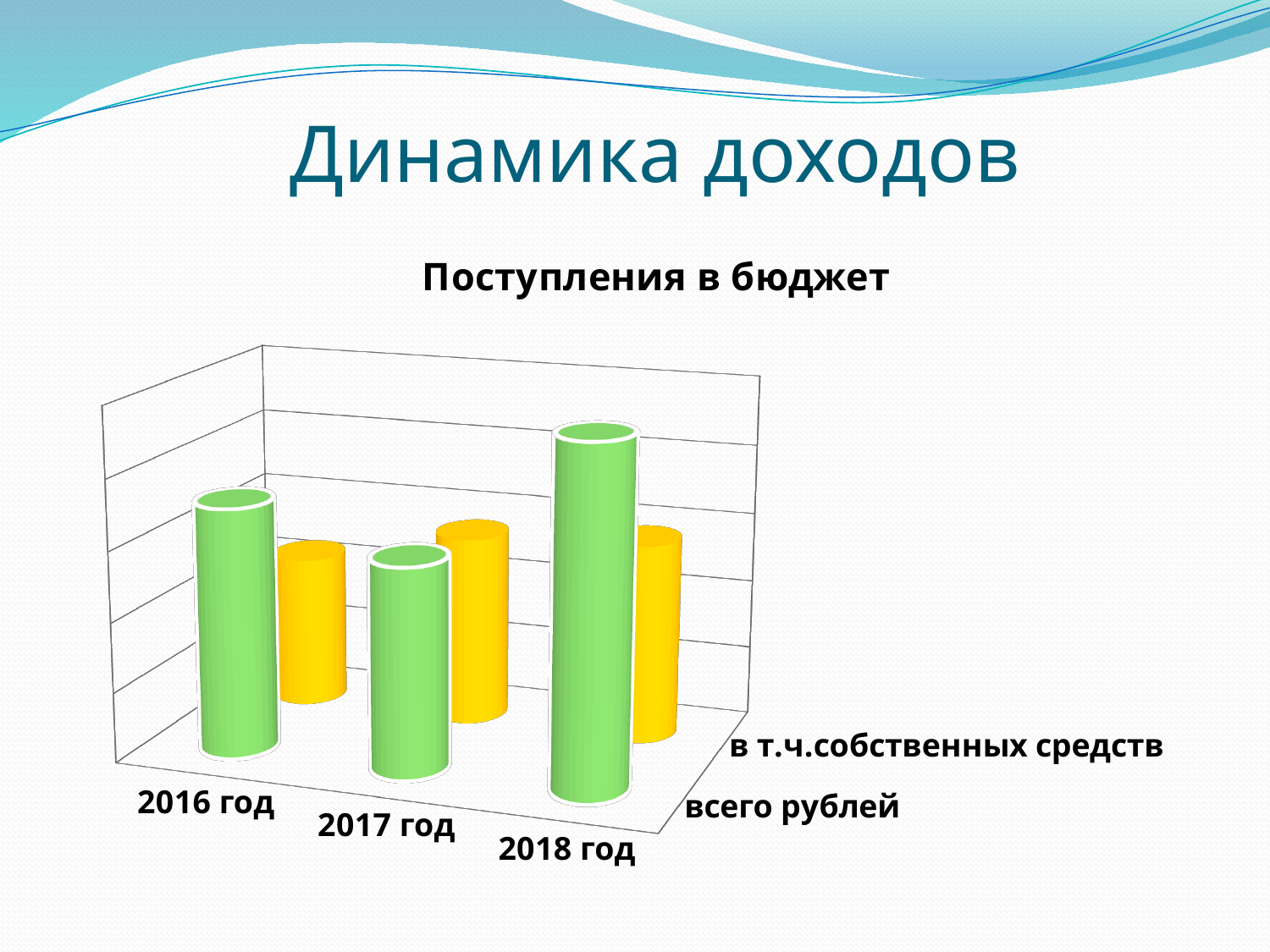
What colour are the bars for the series всего рублей? green Which is larger for всего рублей: 2016 год or 2018 год? 2018 год What is the title of the chart? Поступления в бюджет Which year has the highest value for всего рублей? 2018 год In 2016 год, which series has the larger value: всего рублей or в т.ч.собственных средств? всего рублей Which year has the lowest value for в т.ч.собственных средств? 2016 год Does the value for всего рублей rise or fall from 2016 год to 2017 год? fall Does the value for всего рублей rise or fall from 2017 год to 2018 год? rise Which year has the lowest value for всего рублей? 2017 год How many year categories are shown on the chart? 3 What kind of chart is shown on the slide? bar chart How many series does the chart show? 2